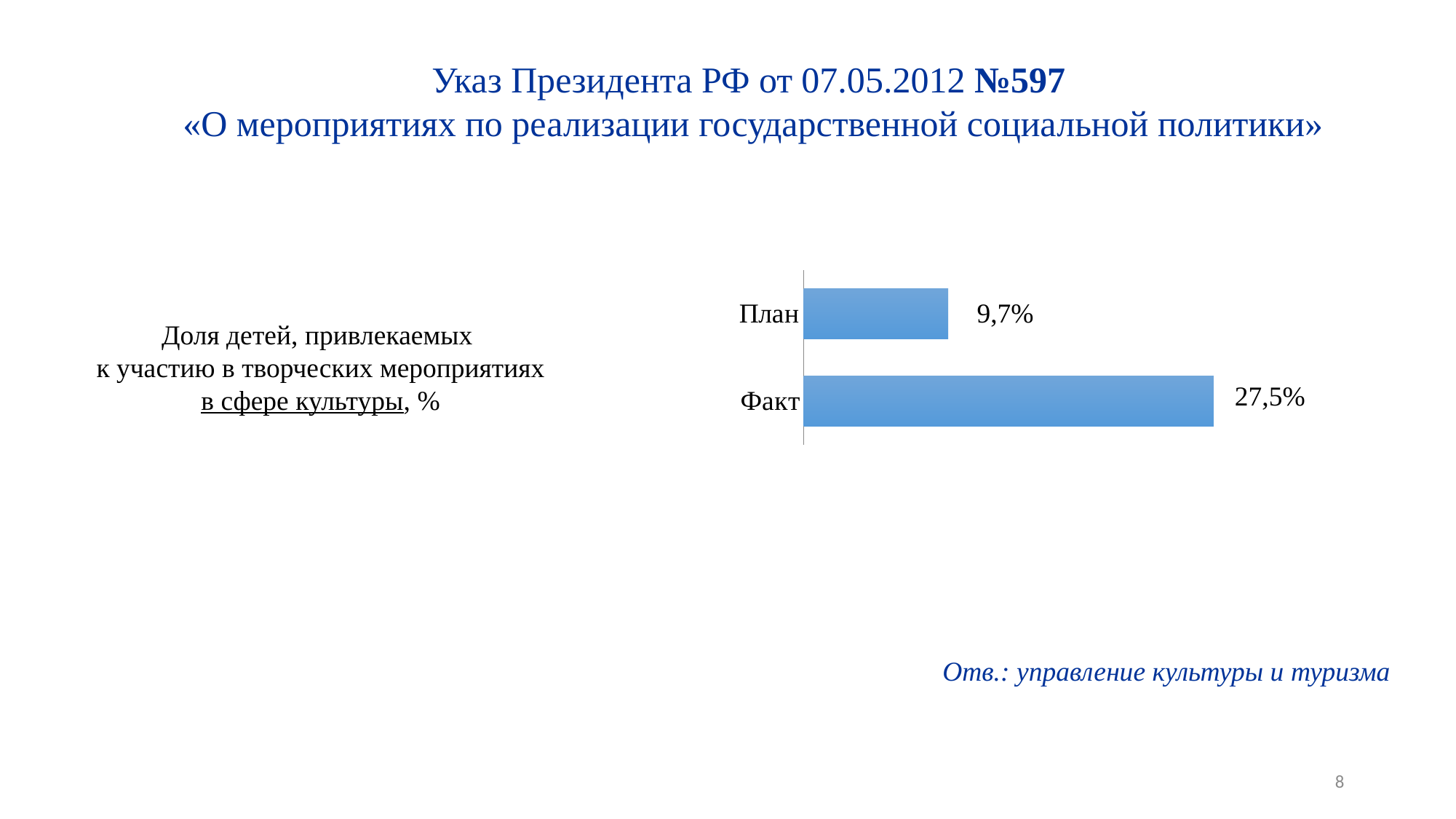
Which category has the highest value? Факт What indicator does the chart describe, according to the text to its left? Доля детей, привлекаемых к участию в творческих мероприятиях в сфере культуры, % What kind of chart is shown on the slide? Bar chart Which category has the lowest value? План What is the value for Факт? 27,5% Which is larger, the value for План or the value for Факт? Факт What is the difference between the values for Факт and План? 17,8% How many categories are shown in the chart? 2 Are the bars in the chart horizontal or vertical? Horizontal What is the value for План? 9,7%